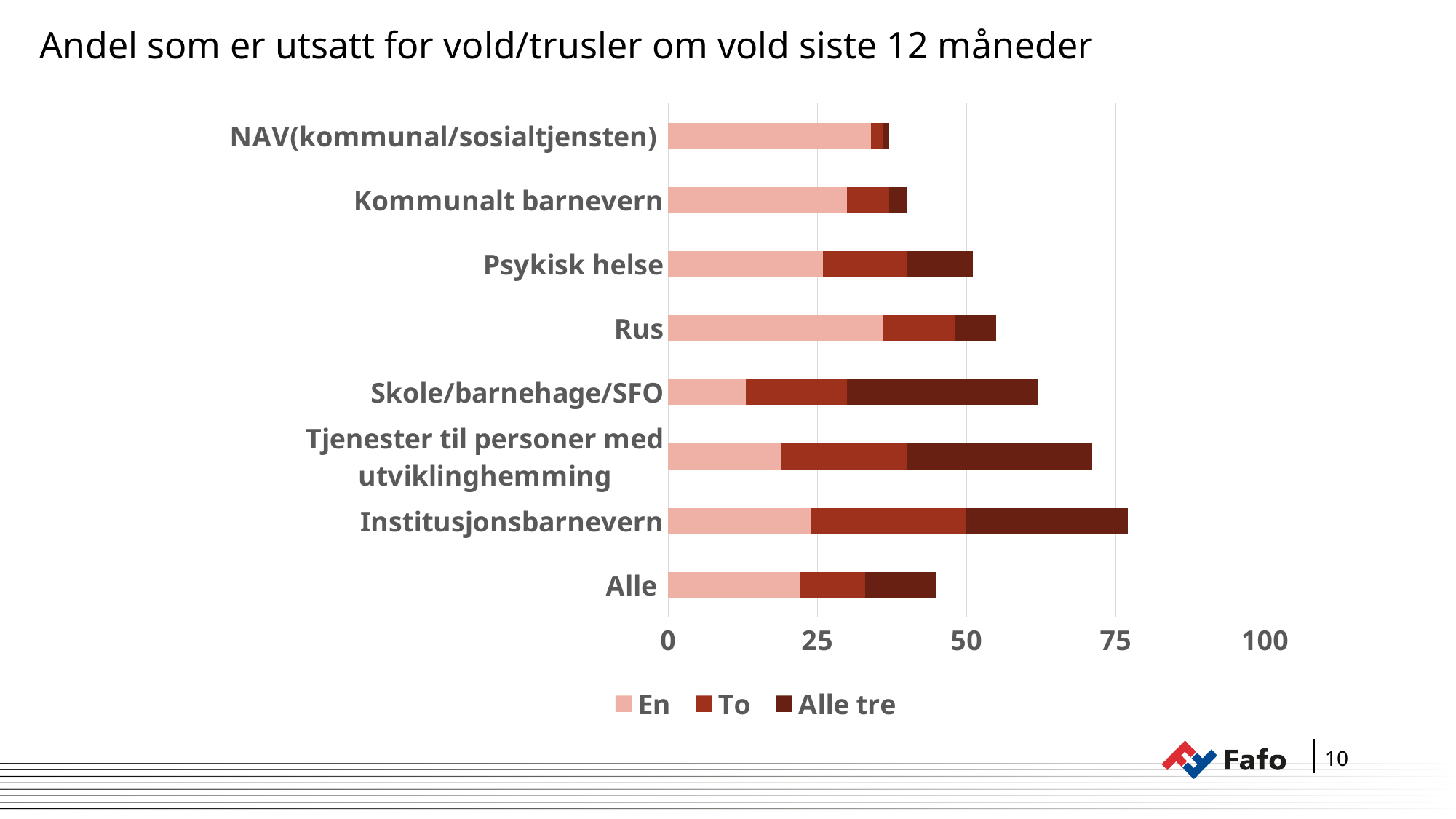
Is the 'En' segment for Rus greater or less than 25? greater Is the 'En' segment for Skole/barnehage/SFO greater or less than 25? less Which has the longer total bar, Institusjonsbarnevern or Psykisk helse? Institusjonsbarnevern How many series does the legend list? 3 Is the total bar for Skole/barnehage/SFO greater or less than 50? greater What are the three series names listed in the legend? En, To, Alle tre Which has the longer total bar, Skole/barnehage/SFO or Rus? Skole/barnehage/SFO How many categories are plotted on the chart? 8 Which category has the longest total bar? Institusjonsbarnevern What kind of chart is shown on the slide? bar chart